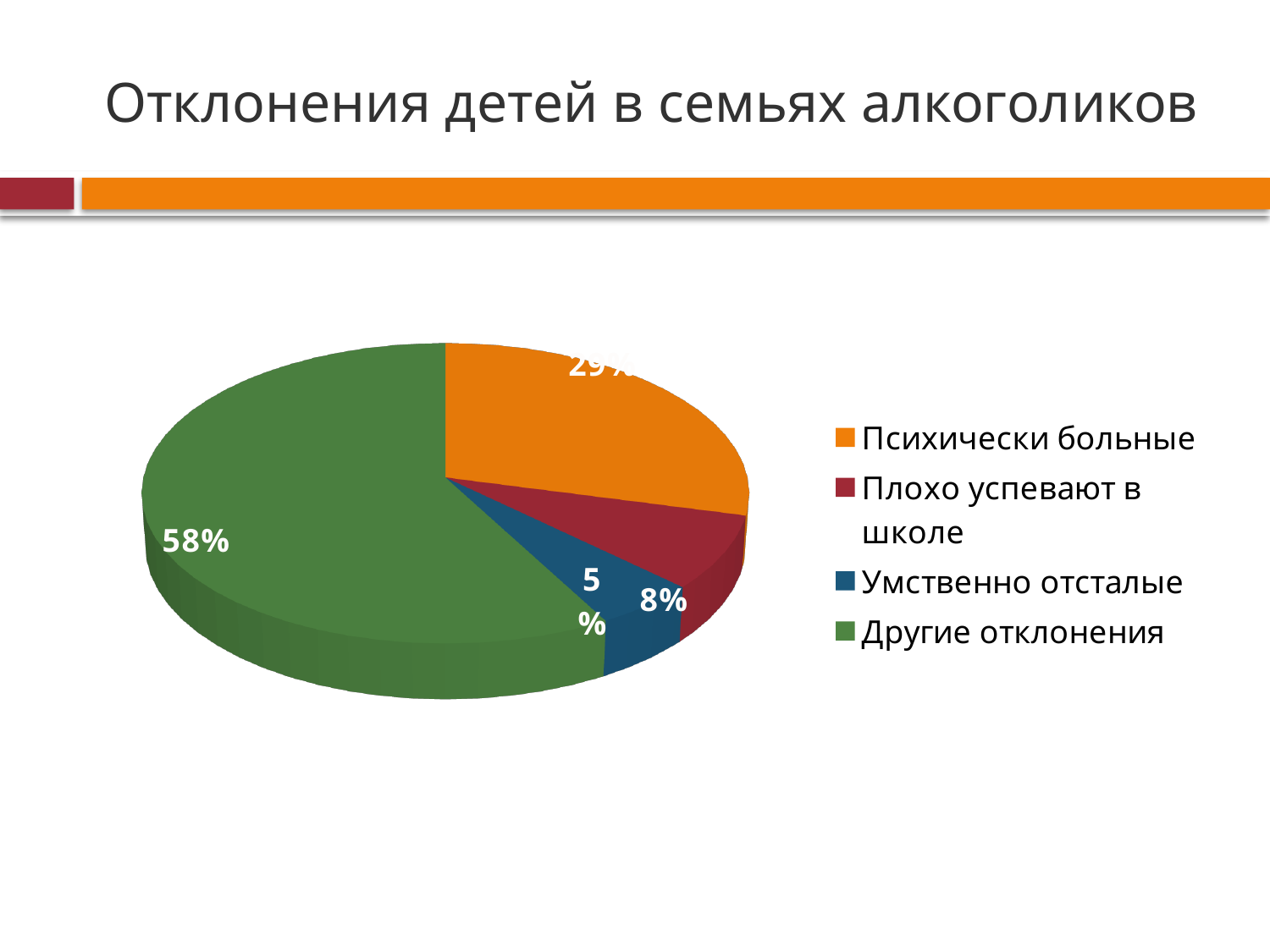
What percentage is shown for Плохо успевают в школе? 8% What is the title of the slide? Отклонения детей в семьях алкоголиков What colour is the slice for Умственно отсталые? blue Which category has the largest share of the pie? Другие отклонения Which is larger: the share for Плохо успевают в школе or the share for Умственно отсталые? Плохо успевают в школе How many categories does the pie chart have? 4 What percentage is shown for Психически больные? 29% Which category has the smallest share of the pie? Умственно отсталые What percentage is shown for Умственно отсталые? 5% What percentage of the pie is labelled for Другие отклонения? 58% What is the difference in percentage points between Другие отклонения and Плохо успевают в школе? 50 What kind of chart is shown on the slide? pie chart